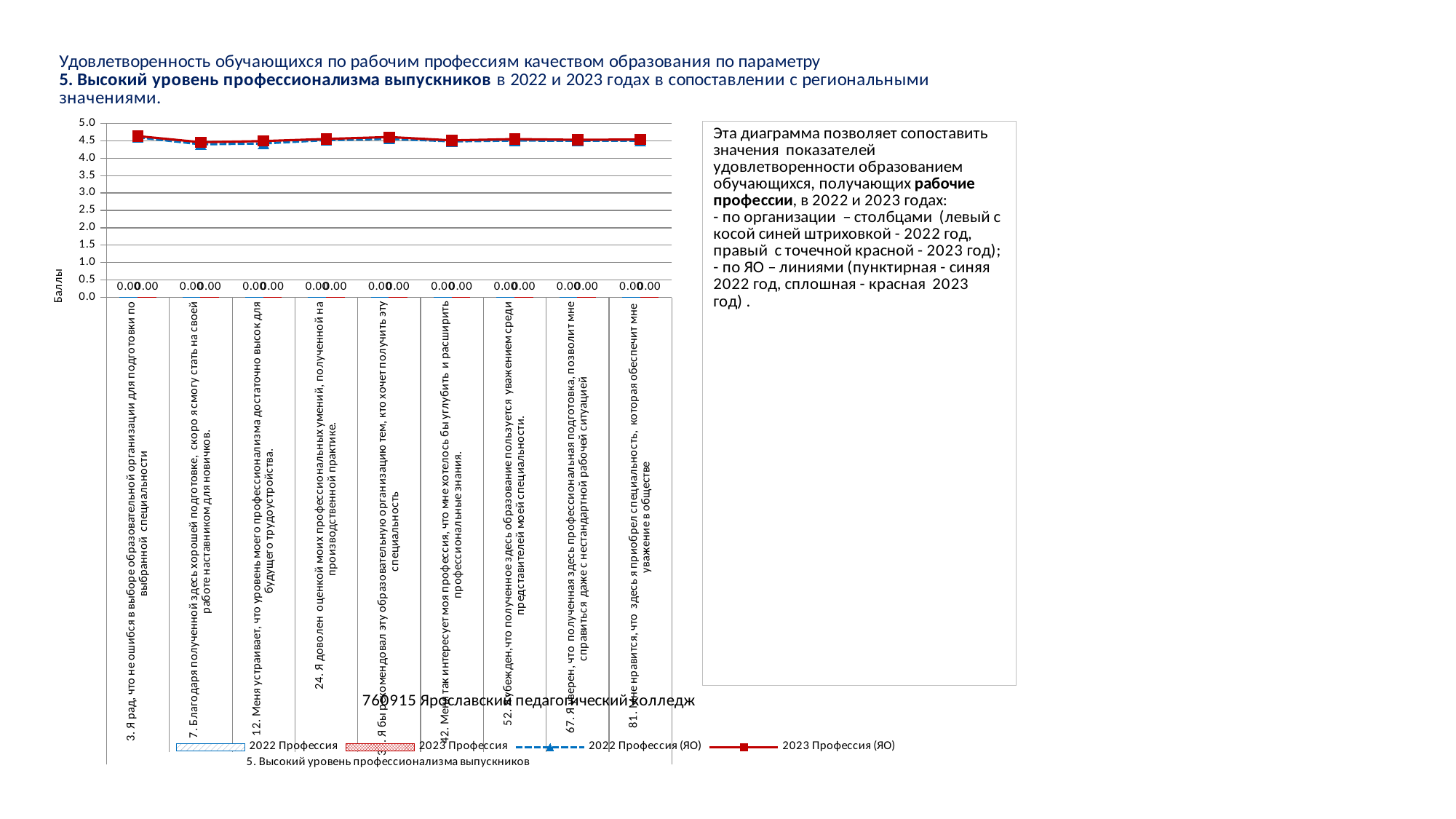
Is the value of the 2023 Профессия (ЯО) line for statement 3 greater or less than 4.0? greater Is the value of the 2023 Профессия (ЯО) line for statement 52 greater or less than 3.0? greater Is the value of the 2022 Профессия (ЯО) line for statement 7 greater or less than 5.0? less What kind of chart is shown on the slide? Combined bar and line chart What is the value of the 2023 Профессия bar for statement 24 ("Я доволен оценкой моих профессиональных умений...")? 0.00 What is the value of the 2023 Профессия bar for statement 81 ("Мне нравится, что здесь я приобрел специальность...")? 0.00 How many categories (statements) are plotted along the x axis of the chart? 9 What colour is the 2023 Профессия (ЯО) line in the chart? Red What is the value of the 2022 Профессия bar for statement 3 ("Я рад, что не ошибся в выборе образовательной организации...")? 0.00 For statement 3, which is larger: the 2022 Профессия bar or the 2022 Профессия (ЯО) line value? 2022 Профессия (ЯО) How many series does the chart legend list? 4 What is the title of the vertical axis of the chart? Баллы